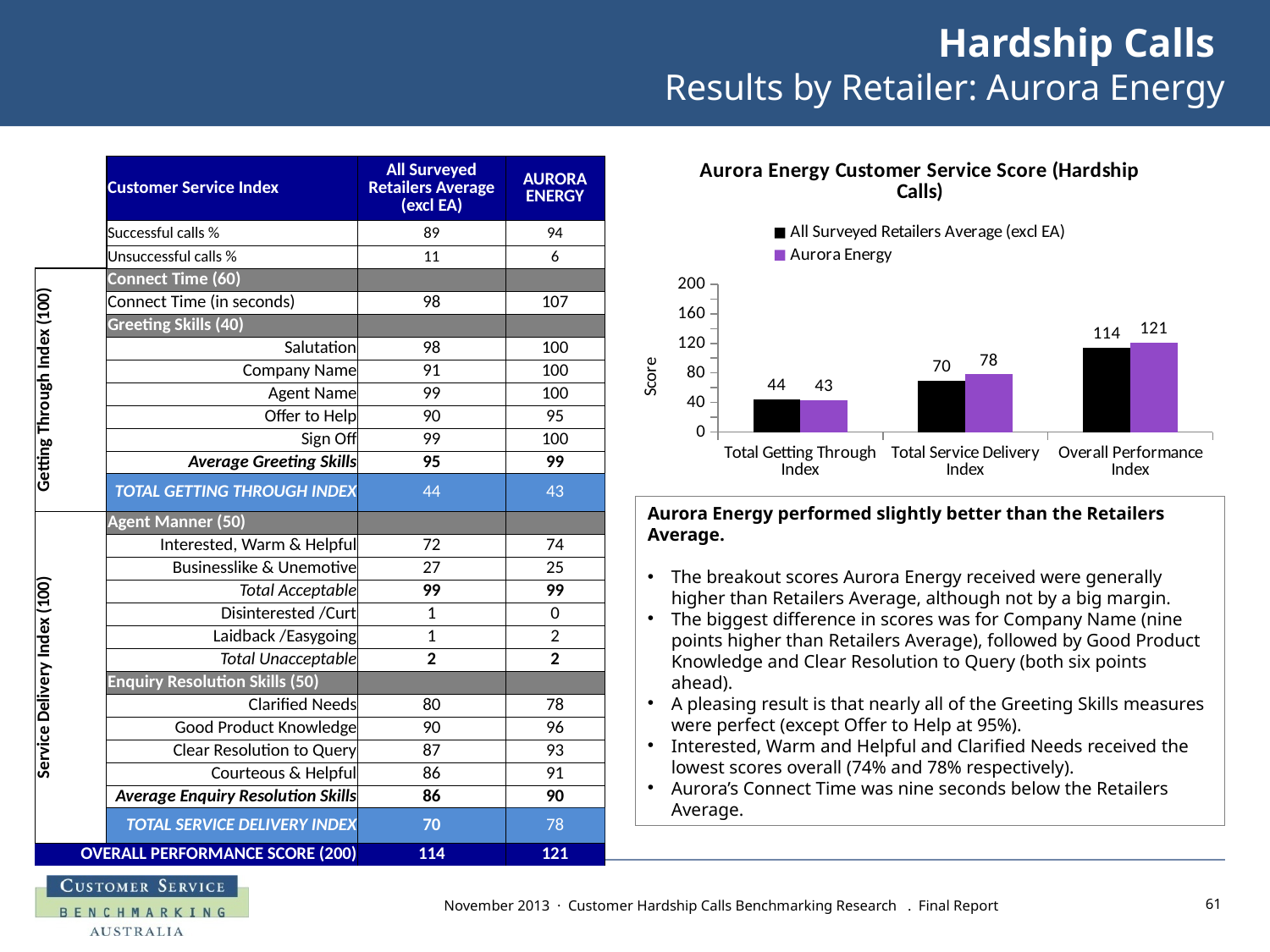
What is the difference between the Aurora Energy and All Surveyed Retailers Average (excl EA) values for Overall Performance Index? 7 Which category has the lowest All Surveyed Retailers Average (excl EA) value? Total Getting Through Index How many categories are shown on the x axis of the chart? 3 Which category has the highest Aurora Energy value? Overall Performance Index What is the difference between the Aurora Energy and All Surveyed Retailers Average (excl EA) values for Total Service Delivery Index? 8 Is the Aurora Energy value for Overall Performance Index greater or less than 120? greater What is the All Surveyed Retailers Average (excl EA) value for Overall Performance Index? 114 For Total Service Delivery Index, which series has the larger value: Aurora Energy or All Surveyed Retailers Average (excl EA)? Aurora Energy What kind of chart is shown on the slide? bar chart How many series does the chart's legend list? 2 What is the Aurora Energy value for Total Getting Through Index? 43 What is the Aurora Energy value for Total Service Delivery Index? 78